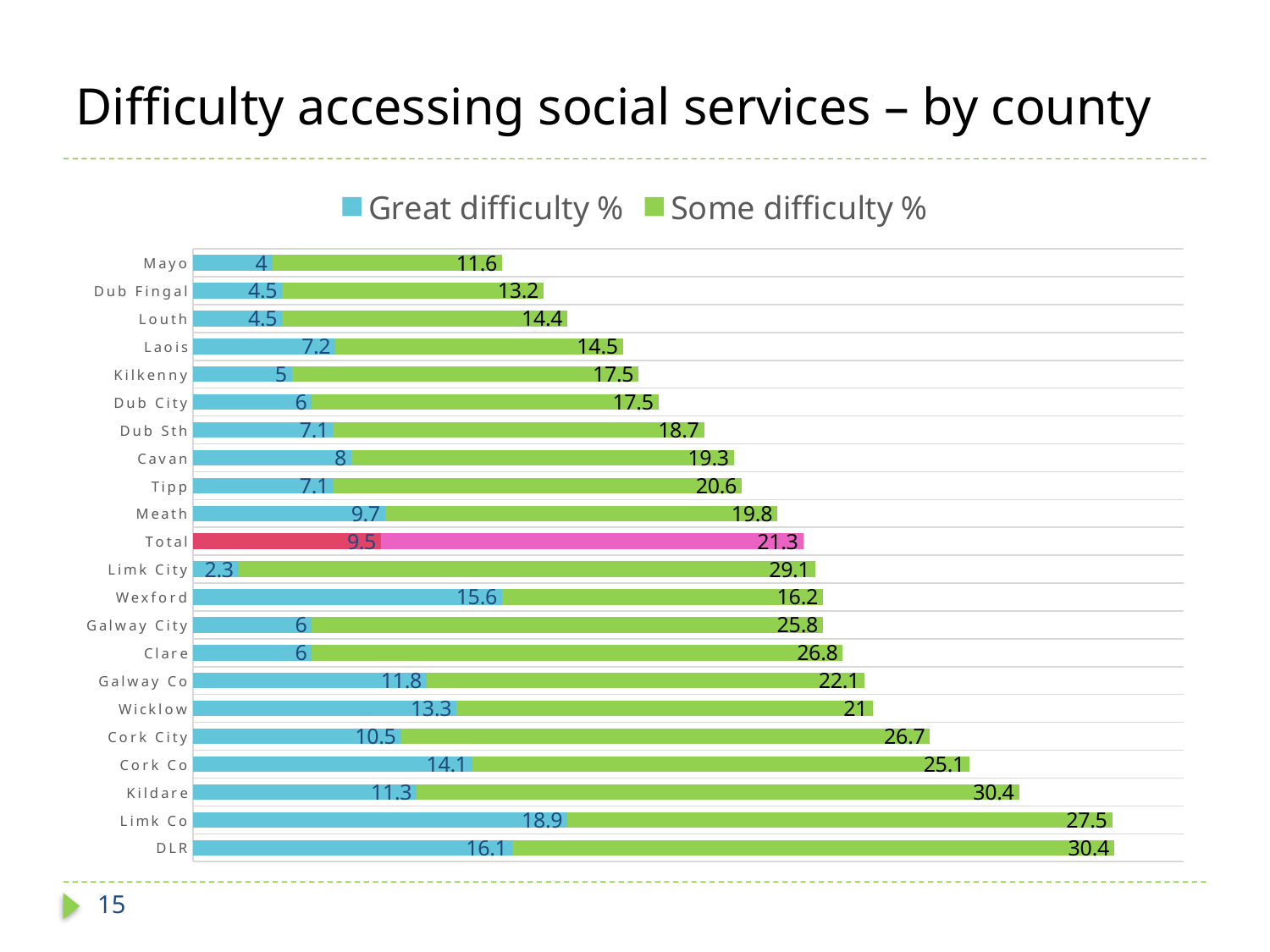
What is the Great difficulty % value for Meath? 9.7 What is the Some difficulty % value for Cork City? 26.7 How many series does the legend list? 2 How many categories (rows) are shown on the chart? 22 What is the Great difficulty % value for the Total row? 9.5 What kind of chart is shown on the slide? Stacked bar chart Which county has the lowest Great difficulty % value? Limk City Which has the larger Great difficulty % value, Wexford or Cork Co? Wexford What is the combined total of the Great difficulty % and Some difficulty % values for DLR? 46.5 What is the difference between the Some difficulty % and Great difficulty % values for Kildare? 19.1 Which county has the lowest Some difficulty % value? Mayo Which county has the highest Great difficulty % value? Limk Co